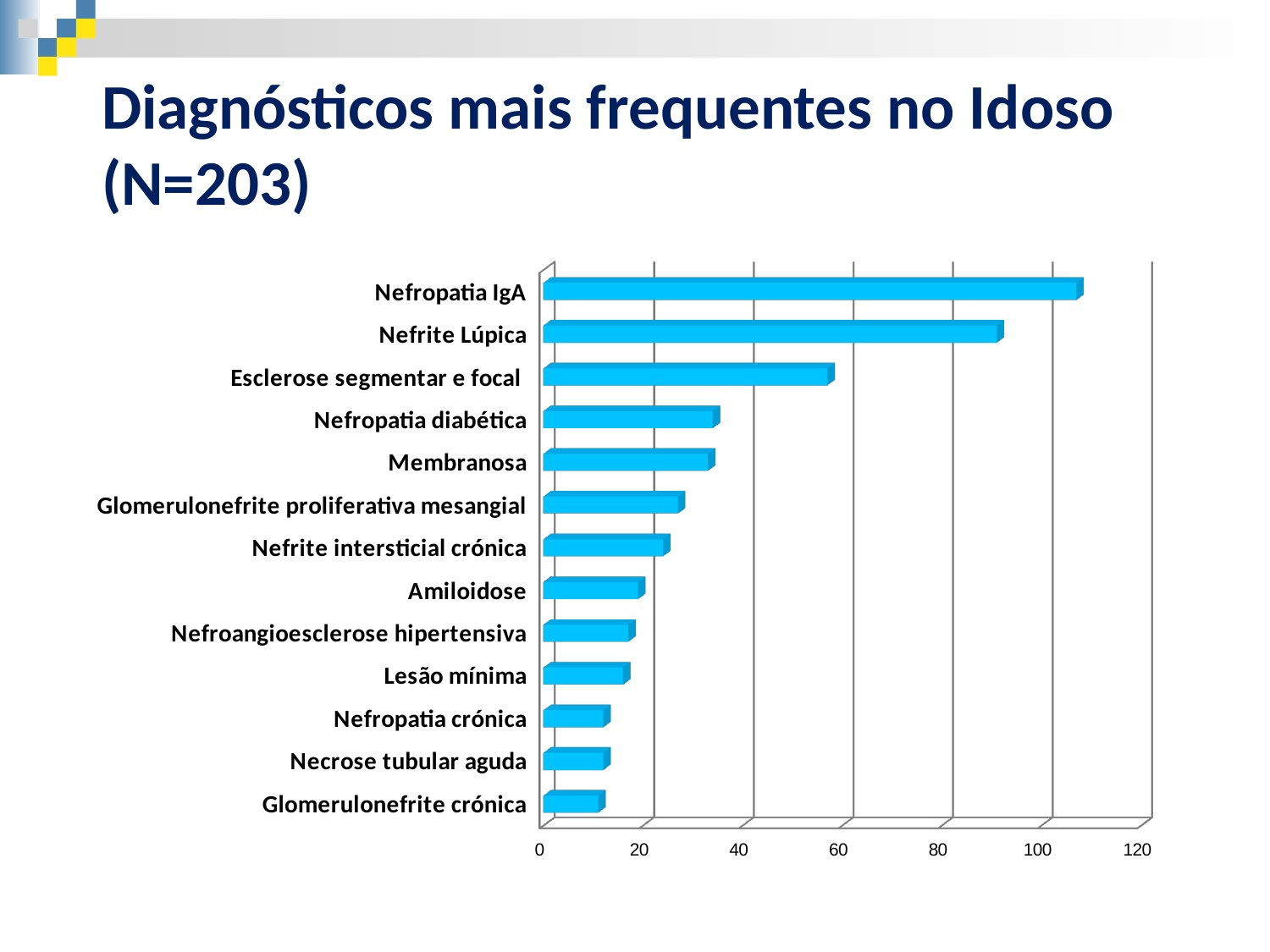
Which is larger, the value for Esclerose segmentar e focal or the value for Membranosa? Esclerose segmentar e focal Is the value for Nefropatia IgA greater or less than 100? greater Which diagnosis has the highest value in the chart? Nefropatia IgA Is the value for Nefrite Lúpica greater or less than 100? less Is the value for Nefropatia diabética greater or less than 40? less What kind of chart is shown on the slide? bar chart Which is larger, the value for Nefropatia IgA or the value for Nefrite Lúpica? Nefropatia IgA How many diagnoses (categories) are plotted in the chart? 13 What is the title of the slide containing the chart? Diagnósticos mais frequentes no Idoso (N=203)